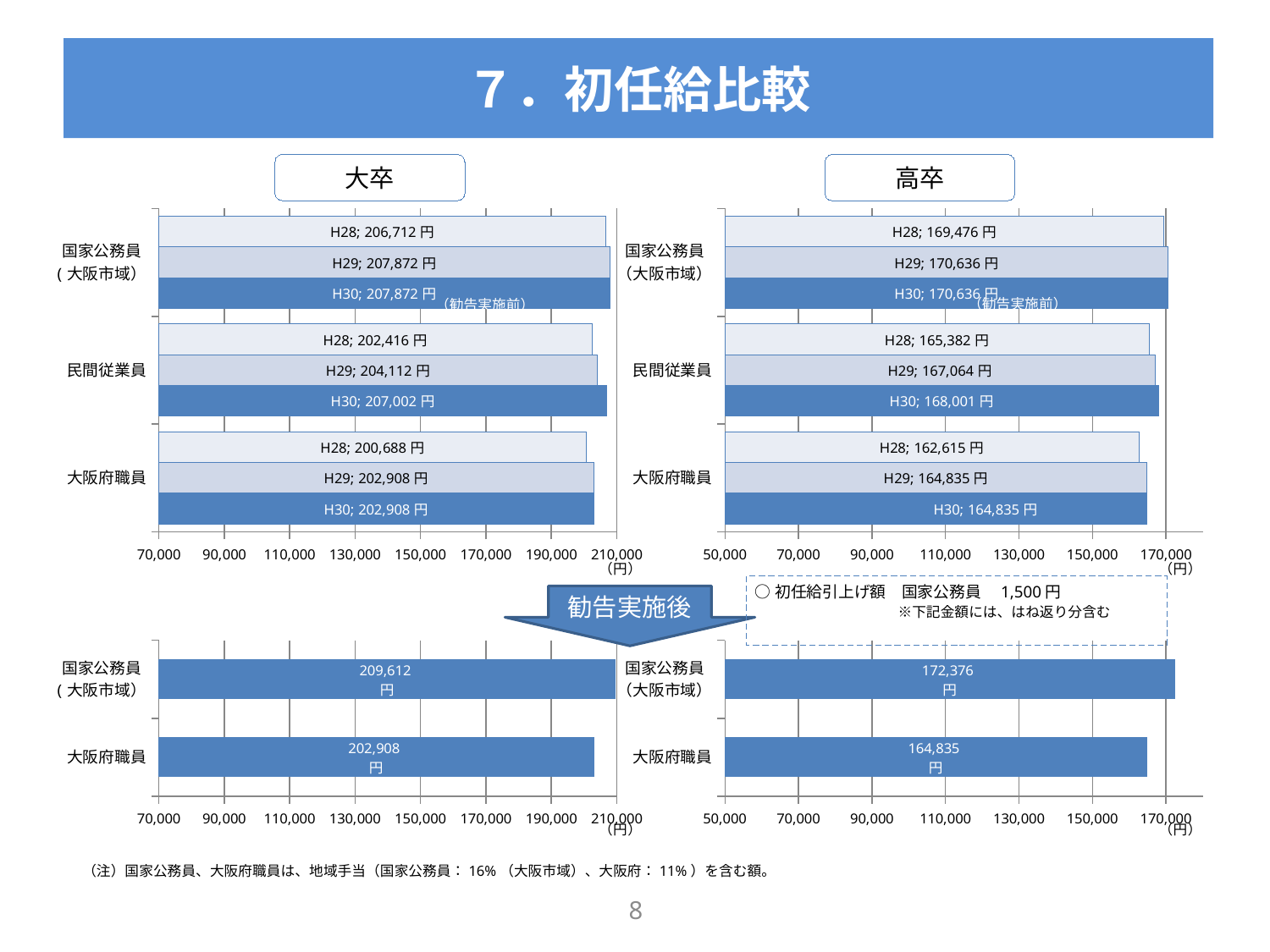
In the bottom-right 高卒 chart (勧告実施後), what is the difference between 国家公務員（大阪市域） and 大阪府職員? 7,541 円 In the top-left 大卒 chart, do the values for 民間従業員 rise or fall from H28 to H30? rise What kind of chart is the bottom-right 高卒 chart? bar chart In the top-right 高卒 chart, what is the H28 value for 民間従業員? 165,382 円 In the top-left 大卒 chart, what is the H30 value for 民間従業員? 207,002 円 How many categories are shown in the top-left 大卒 chart? 3 In the bottom-left 大卒 chart (勧告実施後), what is the value for 国家公務員（大阪市域）? 209,612 円 In the top-left 大卒 chart, which category has the lowest H28 value? 大阪府職員 In the top-left 大卒 chart, what is the H28 value for 国家公務員（大阪市域）? 206,712 円 In the top-right 高卒 chart, what is the H29 value for 大阪府職員? 164,835 円 In the top-right 高卒 chart, which is larger for H30: 国家公務員（大阪市域） or 民間従業員? 国家公務員（大阪市域） In the bottom-left 大卒 chart (勧告実施後), what is the difference between 国家公務員（大阪市域） and 大阪府職員? 6,704 円